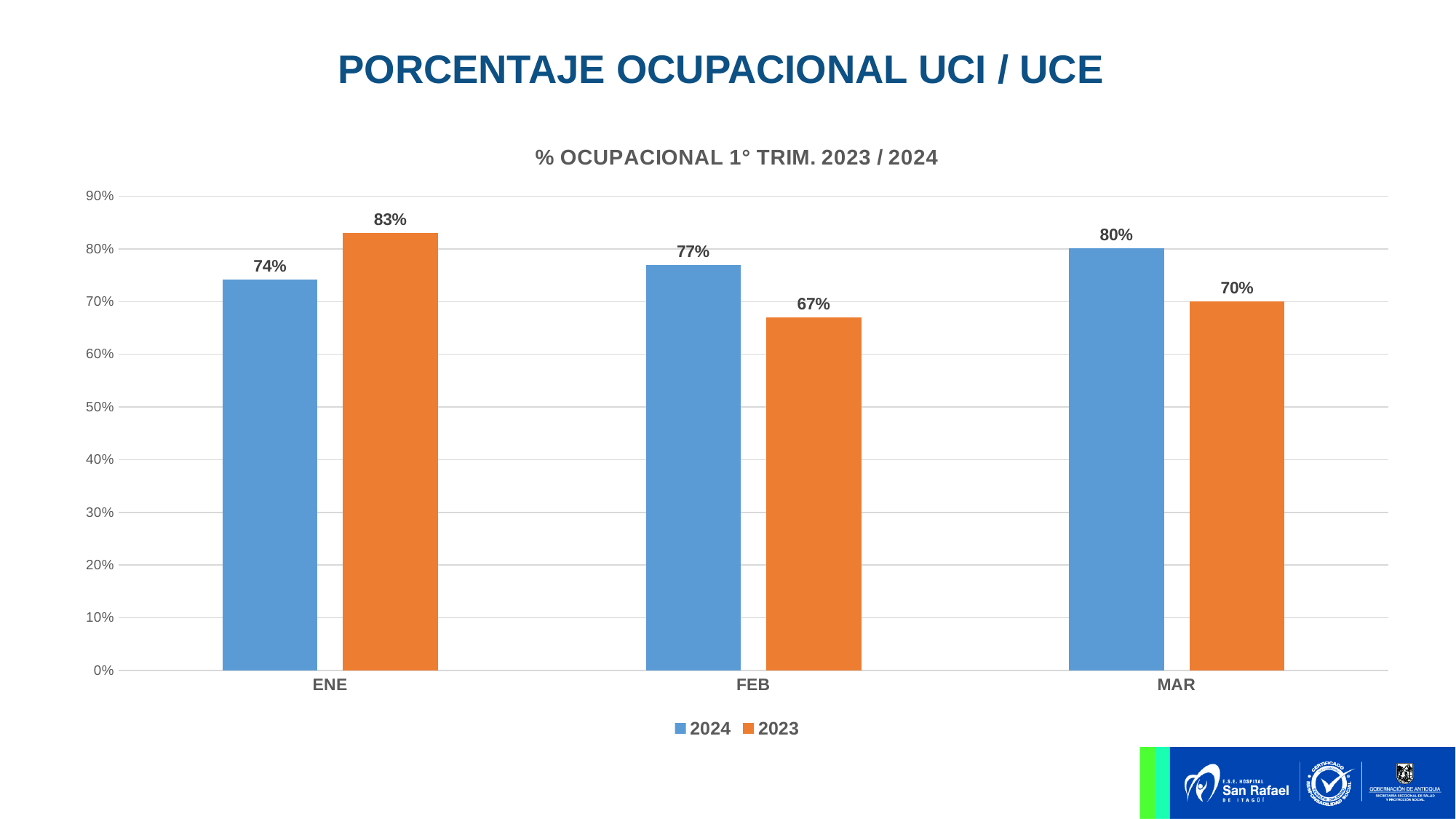
How many months are shown on the x axis? 3 Which is larger in FEB, the 2024 value or the 2023 value? 2024 What kind of chart is shown? bar chart What is the difference between the 2023 and 2024 values in ENE? 9% Is the 2023 value for MAR greater or less than 60%? greater In which month is the 2024 value highest? MAR What is the value for 2024 in ENE? 74% What is the value for 2023 in FEB? 67% What is the value for 2023 in MAR? 70% How many series does the legend list? 2 In which month is the 2023 value lowest? FEB What is the title of the chart? % OCUPACIONAL 1° TRIM. 2023 / 2024